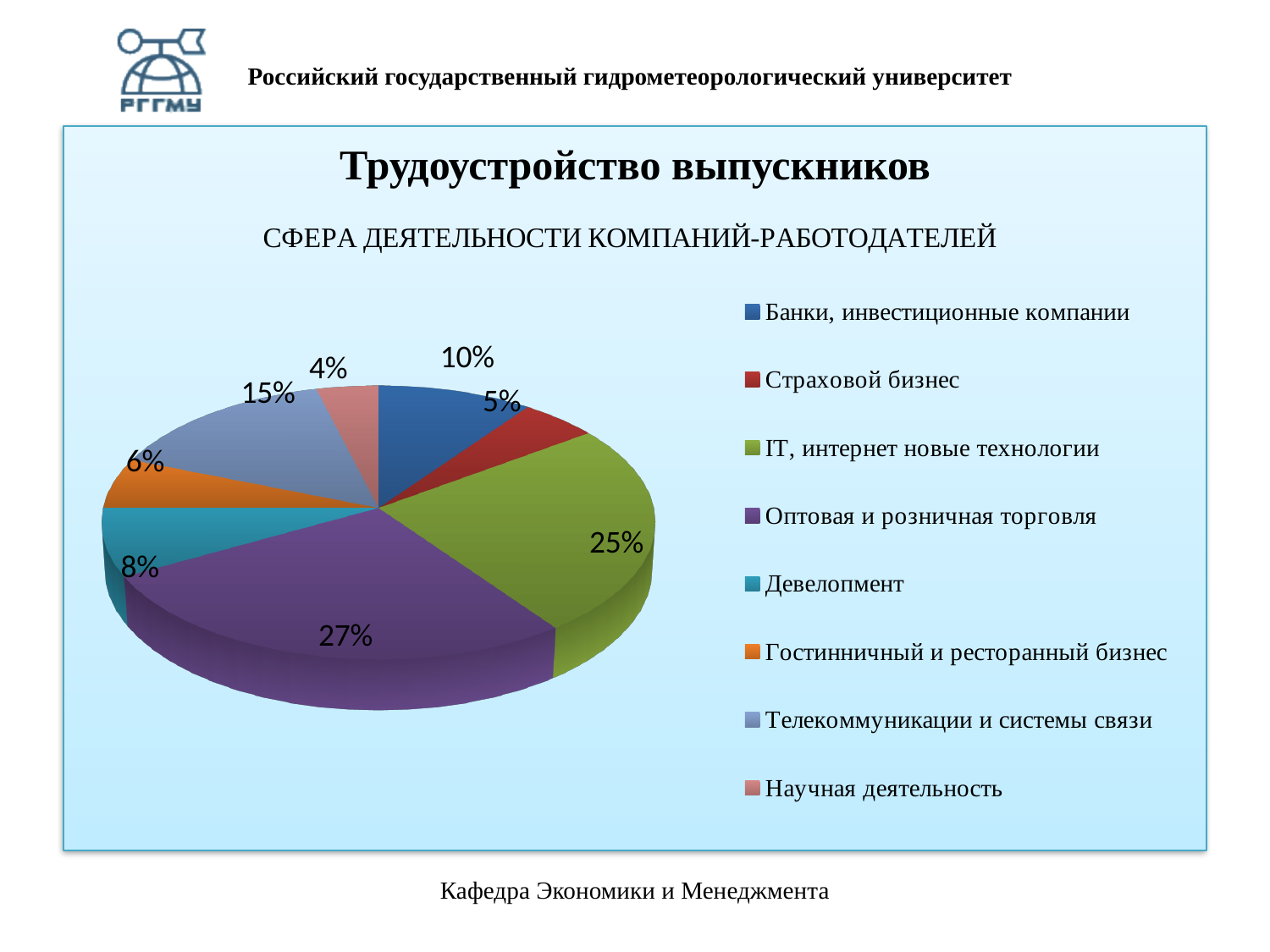
What is the title of the chart? СФЕРА ДЕЯТЕЛЬНОСТИ КОМПАНИЙ-РАБОТОДАТЕЛЕЙ What is the share for Банки, инвестиционные компании? 10% How many categories does the legend list? 8 What is the difference between the shares for Телекоммуникации и системы связи and Девелопмент? 7% Which category has the largest share of the pie? Оптовая и розничная торговля What is the share for IT, интернет новые технологии? 25% What is the share for Телекоммуникации и системы связи? 15% Which category has the smallest share of the pie? Научная деятельность What is the share for Оптовая и розничная торговля? 27% What is the share for Научная деятельность? 4% What kind of chart is shown on the slide? pie chart Which is larger, the share for Страховой бизнес or the share for Гостинничный и ресторанный бизнес? Гостинничный и ресторанный бизнес